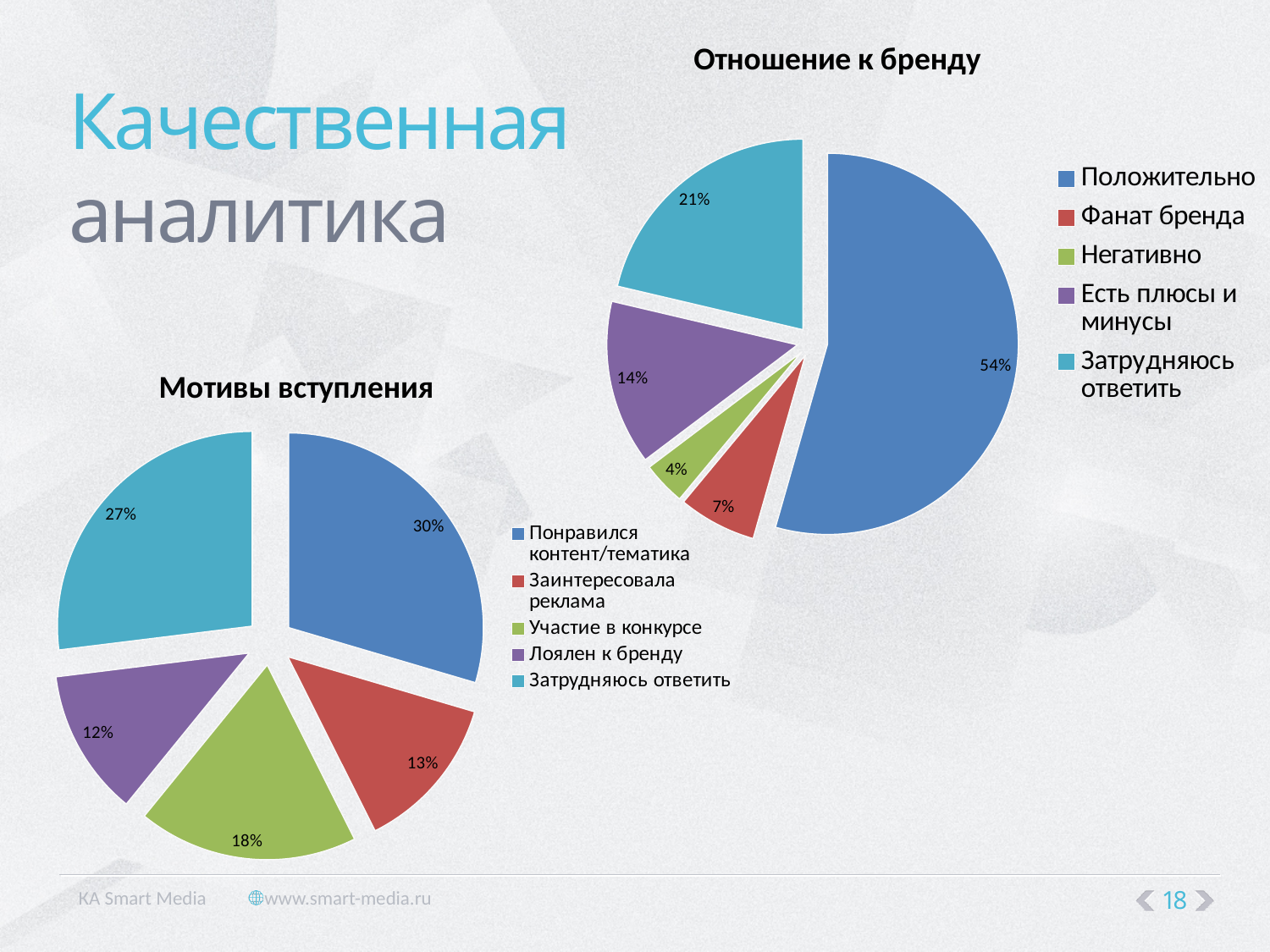
What type of chart is "Мотивы вступления"? Pie chart In the "Мотивы вступления" chart, which category has the largest slice? Понравился контент/тематика In the "Мотивы вступления" chart, what share is labelled for "Участие в конкурсе"? 18% In the "Мотивы вступления" chart, which category has the smallest slice? Лоялен к бренду In the "Отношение к бренду" chart, what share is labelled for "Негативно"? 4% In the "Мотивы вступления" chart, which is larger: "Заинтересовала реклама" or "Участие в конкурсе"? Участие в конкурсе In the "Отношение к бренду" chart, how many categories does the legend list? 5 In the "Отношение к бренду" chart, what is the difference between "Затрудняюсь ответить" and "Есть плюсы и минусы"? 7% In the "Отношение к бренду" chart, which category has the smallest slice? Негативно In the "Отношение к бренду" chart, which category has the largest slice? Положительно In the "Отношение к бренду" chart, what share is labelled for "Положительно"? 54% In the "Мотивы вступления" chart, what share is labelled for "Затрудняюсь ответить"? 27%